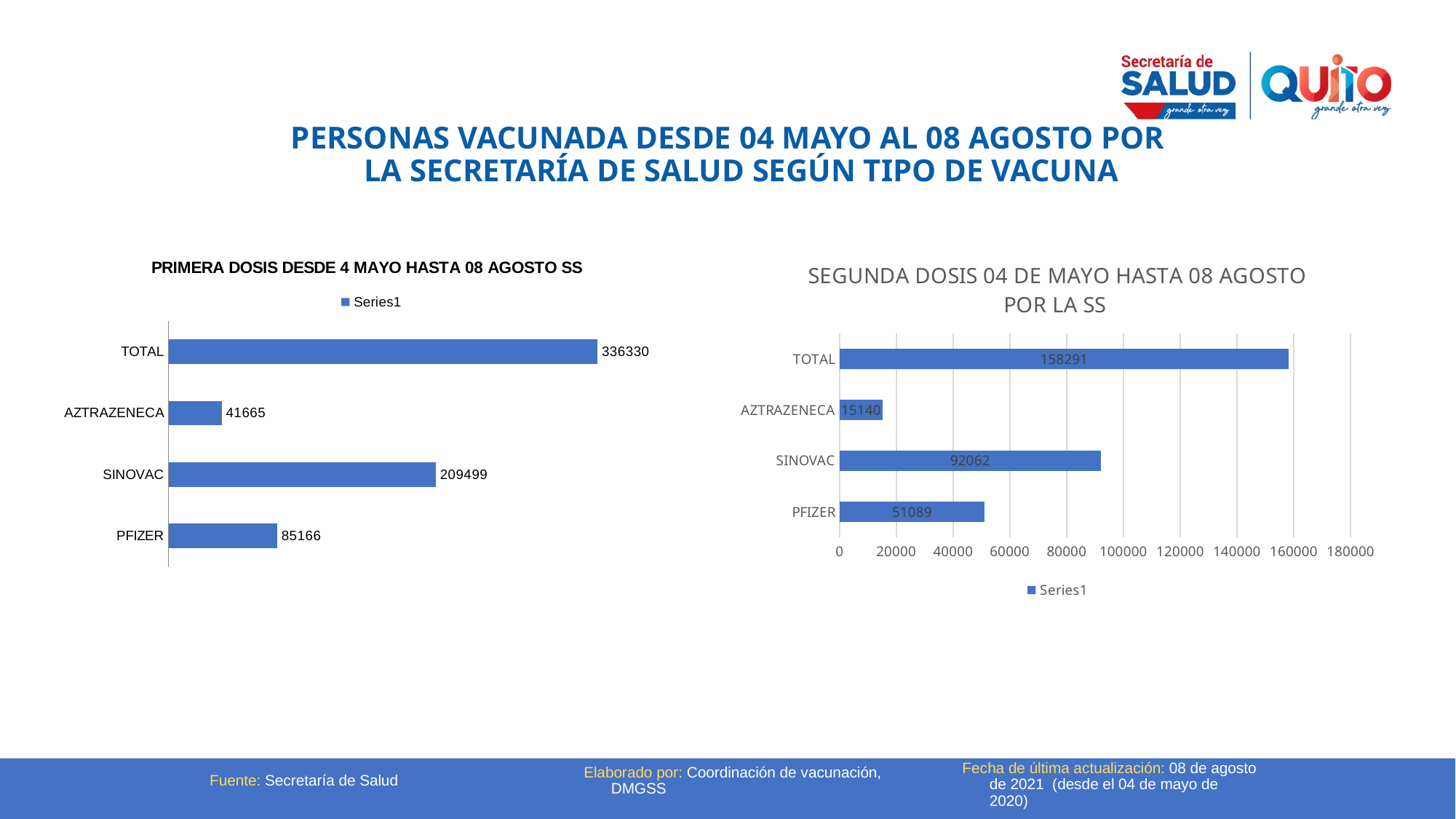
In the chart titled 'PRIMERA DOSIS DESDE 4 MAYO HASTA 08 AGOSTO SS', what is the difference between the values for SINOVAC and PFIZER? 124333 In the chart titled 'PRIMERA DOSIS DESDE 4 MAYO HASTA 08 AGOSTO SS', which vaccine type (excluding TOTAL) has the lowest value? AZTRAZENECA In the chart titled 'PRIMERA DOSIS DESDE 4 MAYO HASTA 08 AGOSTO SS', what is the value for AZTRAZENECA? 41665 In the chart titled 'SEGUNDA DOSIS 04 DE MAYO HASTA 08 AGOSTO POR LA SS', which vaccine type (excluding TOTAL) has the highest value? SINOVAC In the chart titled 'SEGUNDA DOSIS 04 DE MAYO HASTA 08 AGOSTO POR LA SS', which is larger, the value for PFIZER or the value for AZTRAZENECA? PFIZER In the chart titled 'SEGUNDA DOSIS 04 DE MAYO HASTA 08 AGOSTO POR LA SS', what is the difference between the values for SINOVAC and AZTRAZENECA? 76922 In the chart titled 'PRIMERA DOSIS DESDE 4 MAYO HASTA 08 AGOSTO SS', what is the value for SINOVAC? 209499 How many categories are shown in the chart titled 'PRIMERA DOSIS DESDE 4 MAYO HASTA 08 AGOSTO SS'? 4 In the chart titled 'SEGUNDA DOSIS 04 DE MAYO HASTA 08 AGOSTO POR LA SS', what is the value for PFIZER? 51089 In the chart titled 'SEGUNDA DOSIS 04 DE MAYO HASTA 08 AGOSTO POR LA SS', what is the value for TOTAL? 158291 What kind of chart is the chart titled 'SEGUNDA DOSIS 04 DE MAYO HASTA 08 AGOSTO POR LA SS'? Bar chart In the chart titled 'SEGUNDA DOSIS 04 DE MAYO HASTA 08 AGOSTO POR LA SS', is the value for SINOVAC greater or less than 80000? greater